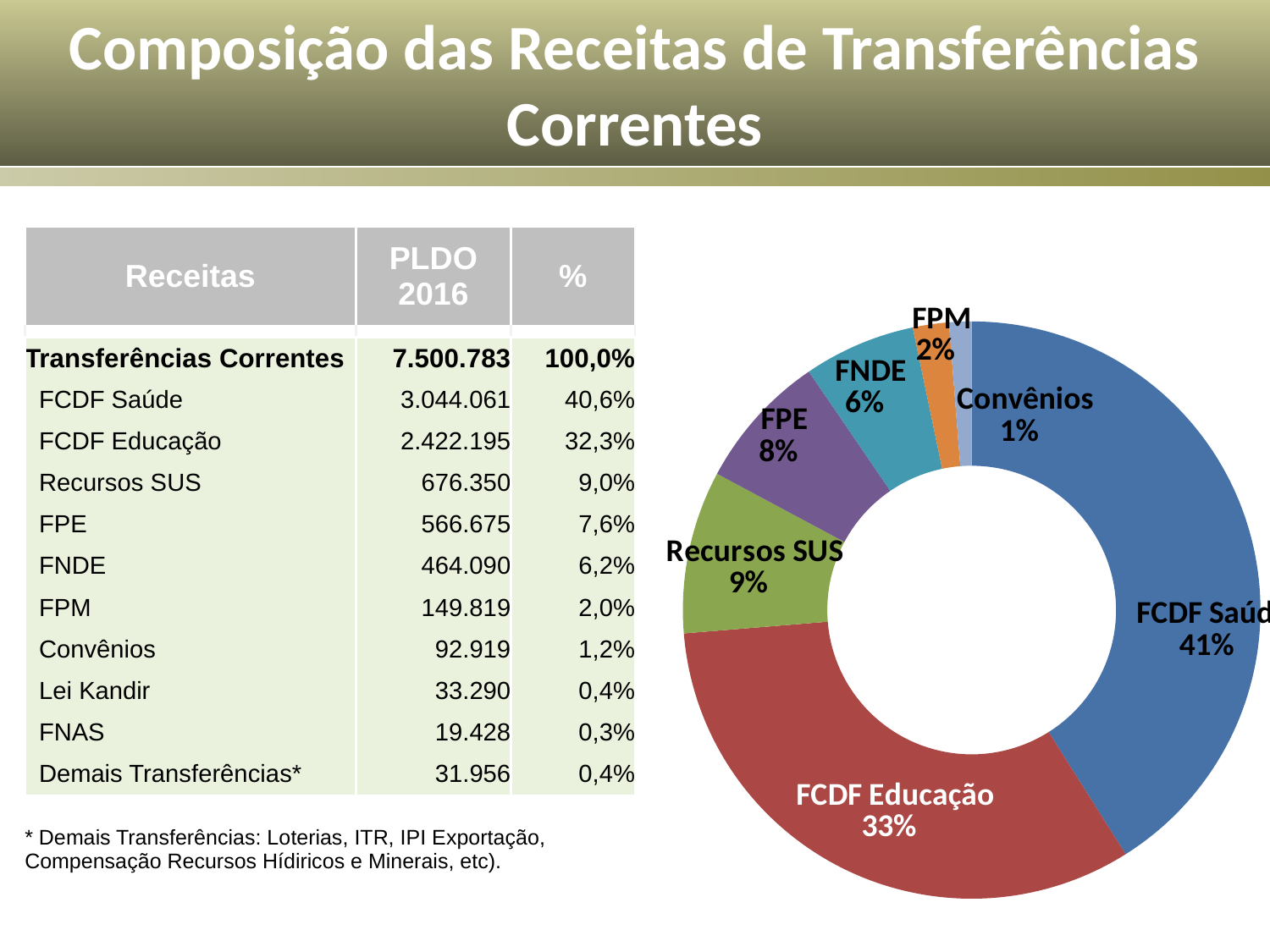
What percentage does the chart show for Recursos SUS? 9% In the chart, what is the difference in percentage points between FCDF Saúde and FCDF Educação? 8 What colour is the FCDF Educação slice in the chart? Red What percentage does the chart show for FNDE? 6% What kind of chart is shown on the right side of the slide? Doughnut chart What percentage does the chart show for Convênios? 1% Which category has the largest slice in the chart? FCDF Saúde What percentage does the chart show for FPE? 8% What percentage does the chart show for FCDF Educação? 33% In the chart, which slice is larger: FPE or FNDE? FPE What percentage does the chart show for FCDF Saúde? 41% Which labelled category has the smallest slice in the chart? Convênios